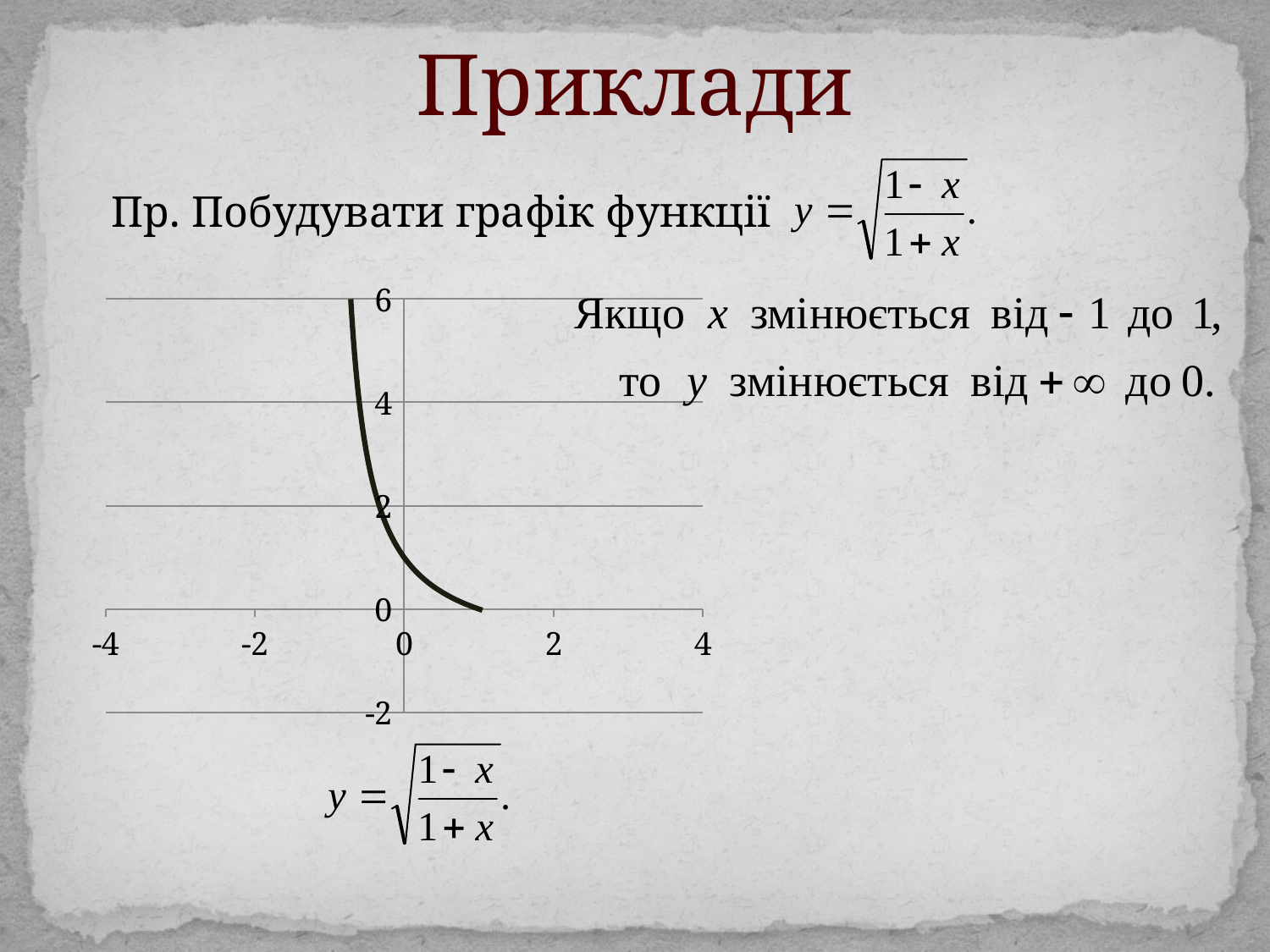
How many tick labels are shown on the vertical axis of the chart? 5 What is the highest value labelled on the vertical axis of the chart? 6 What kind of chart is shown on the slide? line chart Is the value of the curve at x = -0.9 greater or less than 2? greater What is the lowest value labelled on the horizontal axis of the chart? -4 Is the value of the curve at x = -0.9 larger or smaller than its value at x = 0.5? larger Is the value of the curve at x = 0 greater or less than 0? greater What is the y value at the right-hand end of the plotted curve, where it meets the horizontal axis? 0 Does the plotted curve lie above or below the horizontal axis? above How many tick labels are shown on the horizontal axis of the chart? 5 Is the value of the curve at x = 0 greater or less than 2? less As x increases along the x axis, does the plotted curve rise or fall? fall